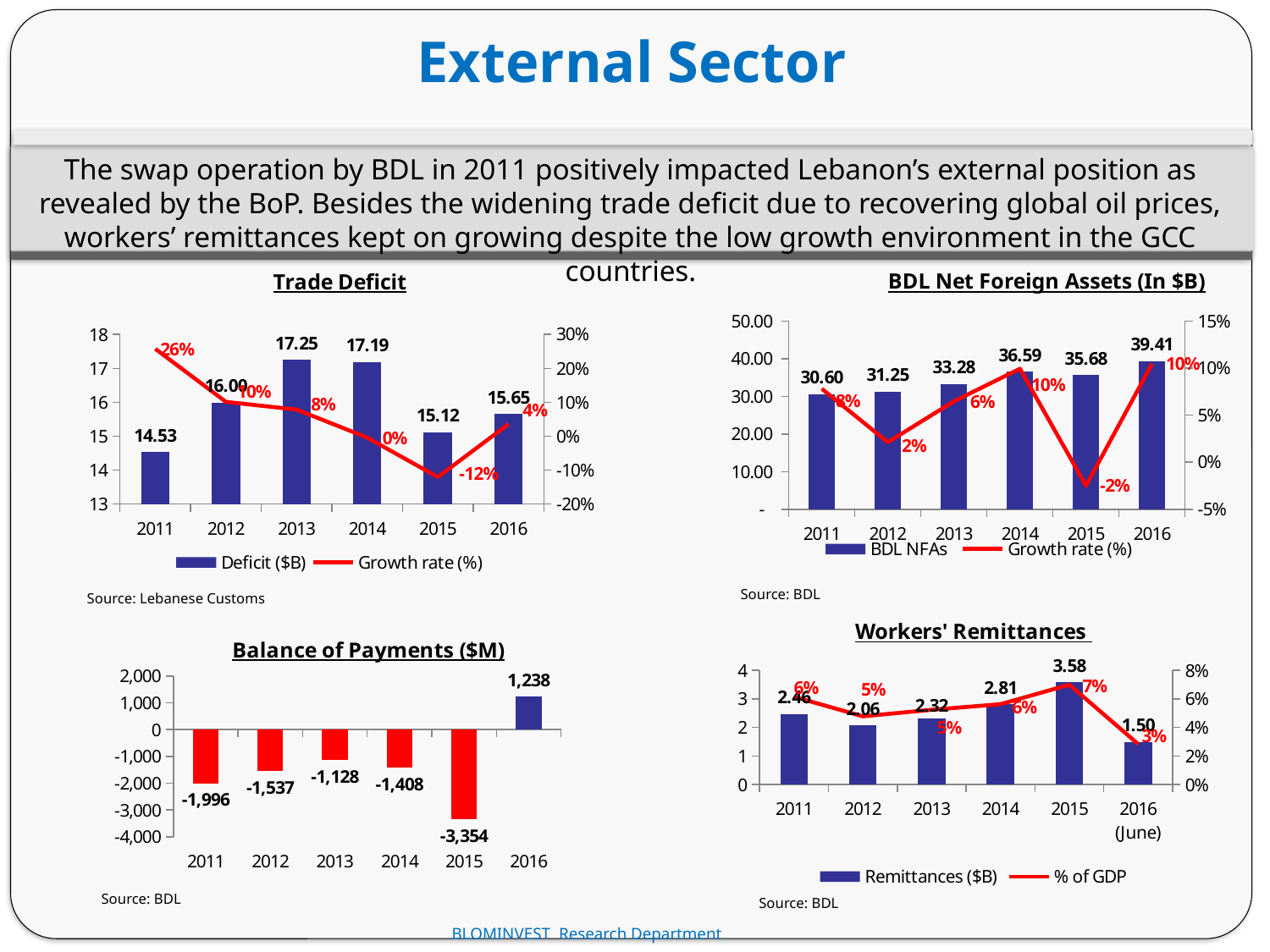
In the Workers' Remittances chart, which year has the highest remittances? 2015 In the Trade Deficit chart, which year has the lowest deficit? 2011 In the Trade Deficit chart, what is the deficit value for 2013? 17.25 In the BDL Net Foreign Assets chart, what is the value for 2016? 39.41 In the Balance of Payments chart, how many years are plotted? 6 In the Balance of Payments chart, which year has the lowest value? 2015 In the Workers' Remittances chart, what is the % of GDP shown for 2016 (June)? 3% In the Workers' Remittances chart, is the remittances value for 2014 larger than the value for 2013? Yes In the Trade Deficit chart, what is the growth rate shown for 2015? -12% In the Balance of Payments chart, what is the value for 2016? 1,238 In the BDL Net Foreign Assets chart, how many series does the legend list? 2 In the BDL Net Foreign Assets chart, what is the difference between the 2014 and 2015 values? 0.91